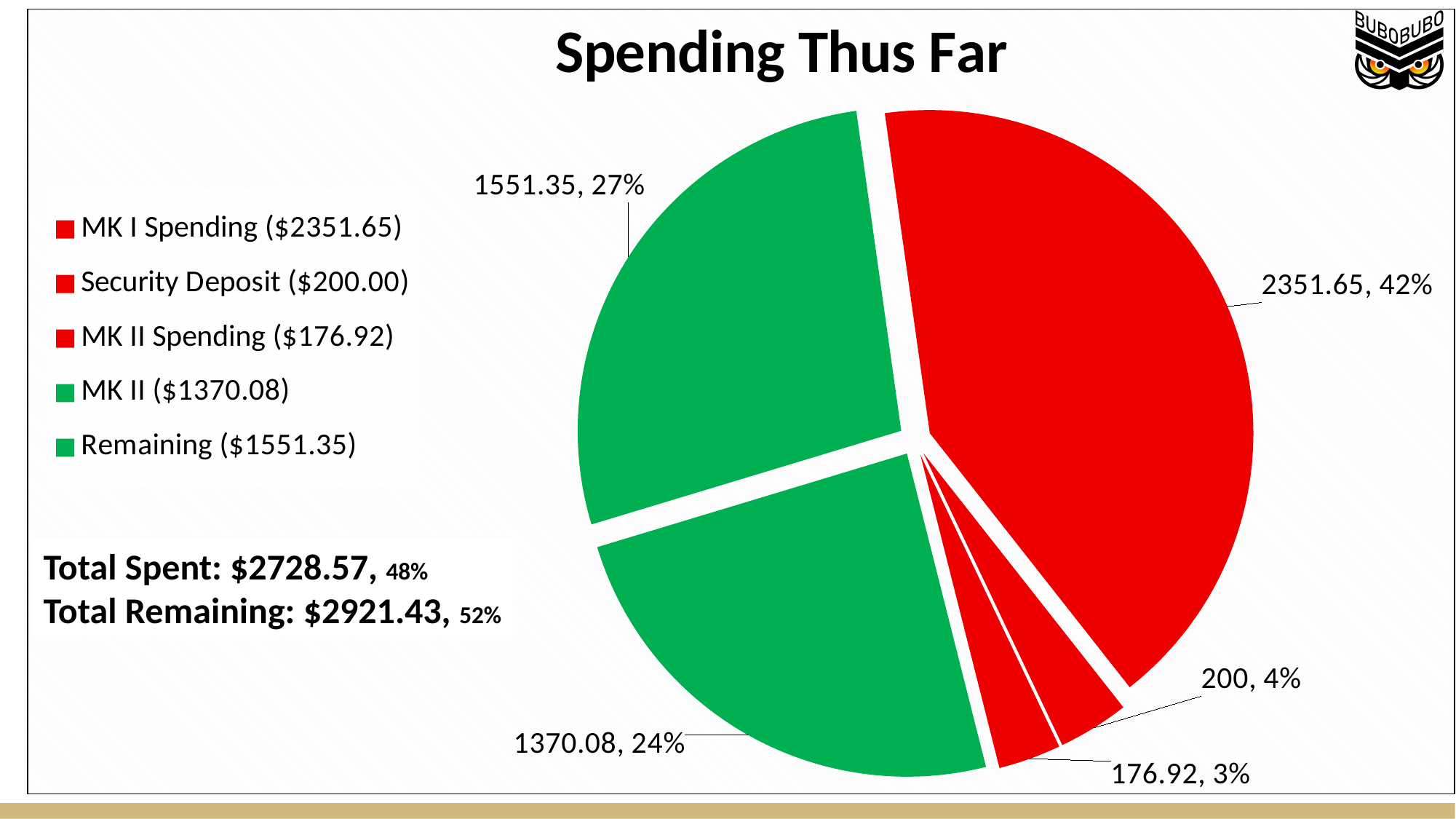
Which category has the largest slice of the pie? MK I Spending Which category has the smallest slice of the pie? MK II Spending Which is larger, the Remaining slice or the MK II slice? Remaining What share of the pie does the Remaining slice represent? 27% What value is labelled on the Security Deposit slice? 200 How many slices does the pie chart have? 5 What is the title of the chart? Spending Thus Far What kind of chart is shown on the slide? Pie chart What is the difference in percentage points between the MK I Spending slice and the Remaining slice? 15% What share of the pie does MK I Spending represent? 42% What value is labelled on the MK II slice? 1370.08 What colour are the MK II and Remaining slices in the legend? Green